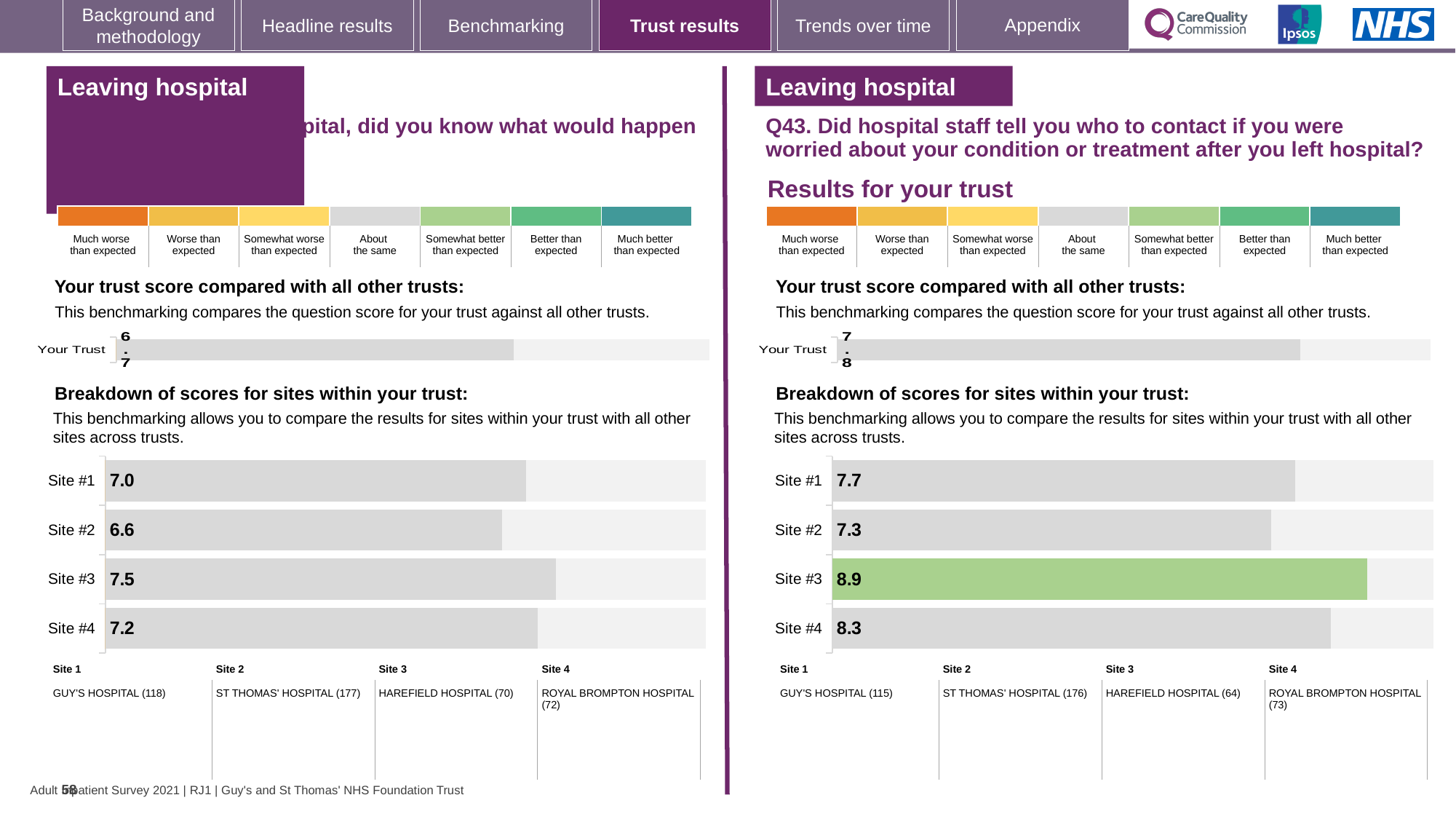
In the site breakdown chart on the left-hand side of the slide, which site has the lowest score? Site #2 In the Q43 site breakdown chart on the right, which site's bar is coloured green rather than grey? Site #3 In the site breakdown chart on the left-hand side of the slide, what is the difference between the scores for Site #3 and Site #2? 0.9 In the Q43 site breakdown chart on the right, which site has the highest score? Site #3 In the 'Your trust score compared with all other trusts' chart for Q43 on the right, what is the score for Your Trust? 7.8 In the site breakdown chart on the left-hand side of the slide, what is the score for Site #2? 6.6 What type of chart is used for the breakdown of scores for sites within your trust on the right-hand side of the slide? Bar chart In the Q43 site breakdown chart on the right, what is the difference between the scores for Site #3 and Site #2? 1.6 In the site breakdown chart on the left-hand side of the slide, which has the higher score, Site #1 or Site #4? Site #4 In the 'Your trust score compared with all other trusts' chart on the left-hand side of the slide, what is the score for Your Trust? 6.7 How many sites are shown in the Q43 site breakdown chart on the right? 4 In the Q43 site breakdown chart on the right, what is the score for Site #3? 8.9